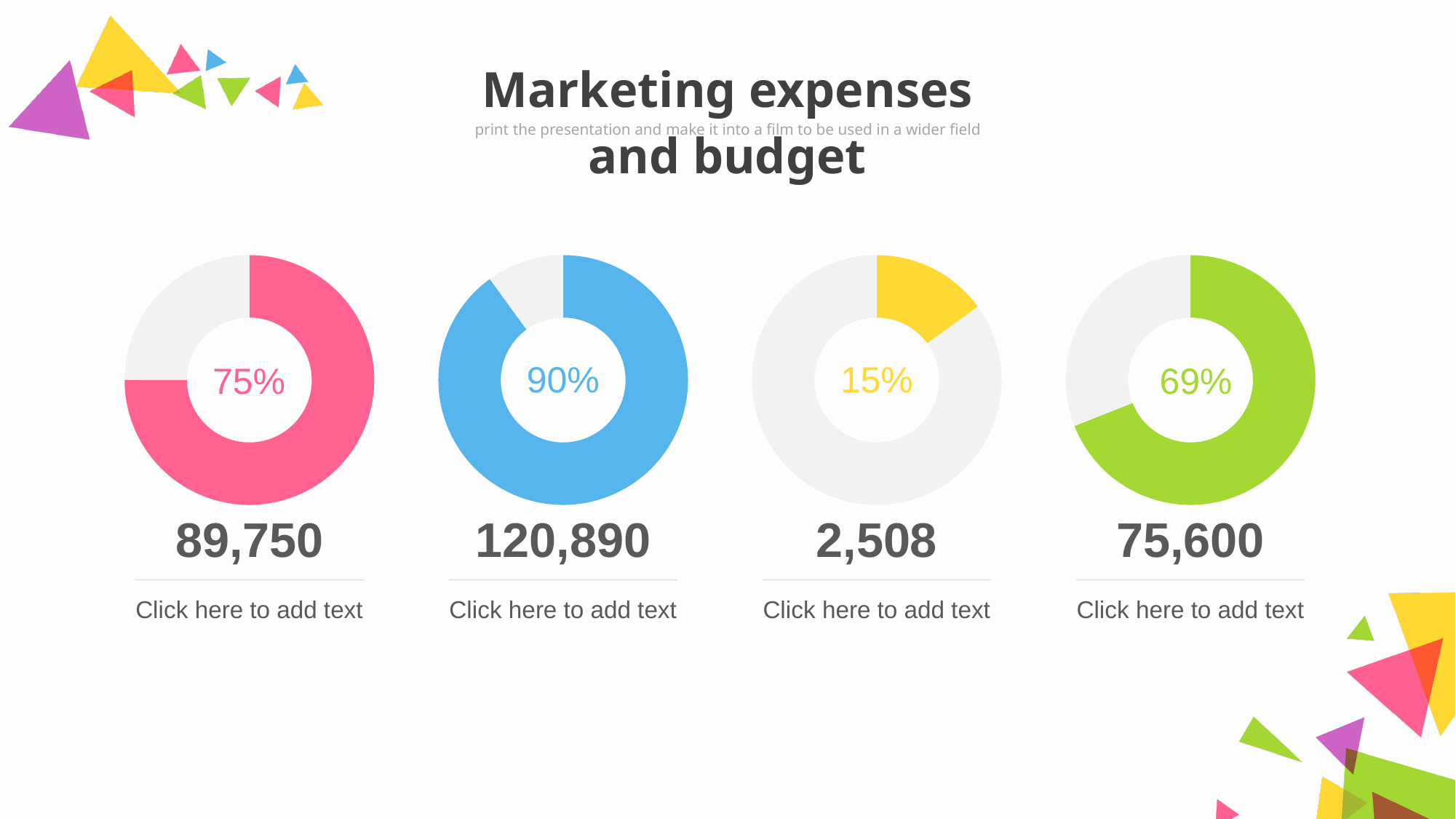
What is the difference between the percentages shown in the blue donut chart and the pink donut chart? 15% Which donut chart shows the lowest percentage? The third (yellow) chart, 15% How many donut charts are shown on the slide? 4 What number is printed below the third (yellow) donut chart? 2,508 What percentage is shown in the centre of the leftmost (pink) donut chart? 75% What percentage is shown in the centre of the second (blue) donut chart? 90% What percentage is shown in the centre of the third (yellow) donut chart? 15% What percentage is shown in the centre of the rightmost (green) donut chart? 69% What number is printed below the leftmost (pink) donut chart? 89,750 What number is printed below the rightmost (green) donut chart? 75,600 Which donut chart shows the highest percentage? The second (blue) chart, 90% What number is printed below the second (blue) donut chart? 120,890